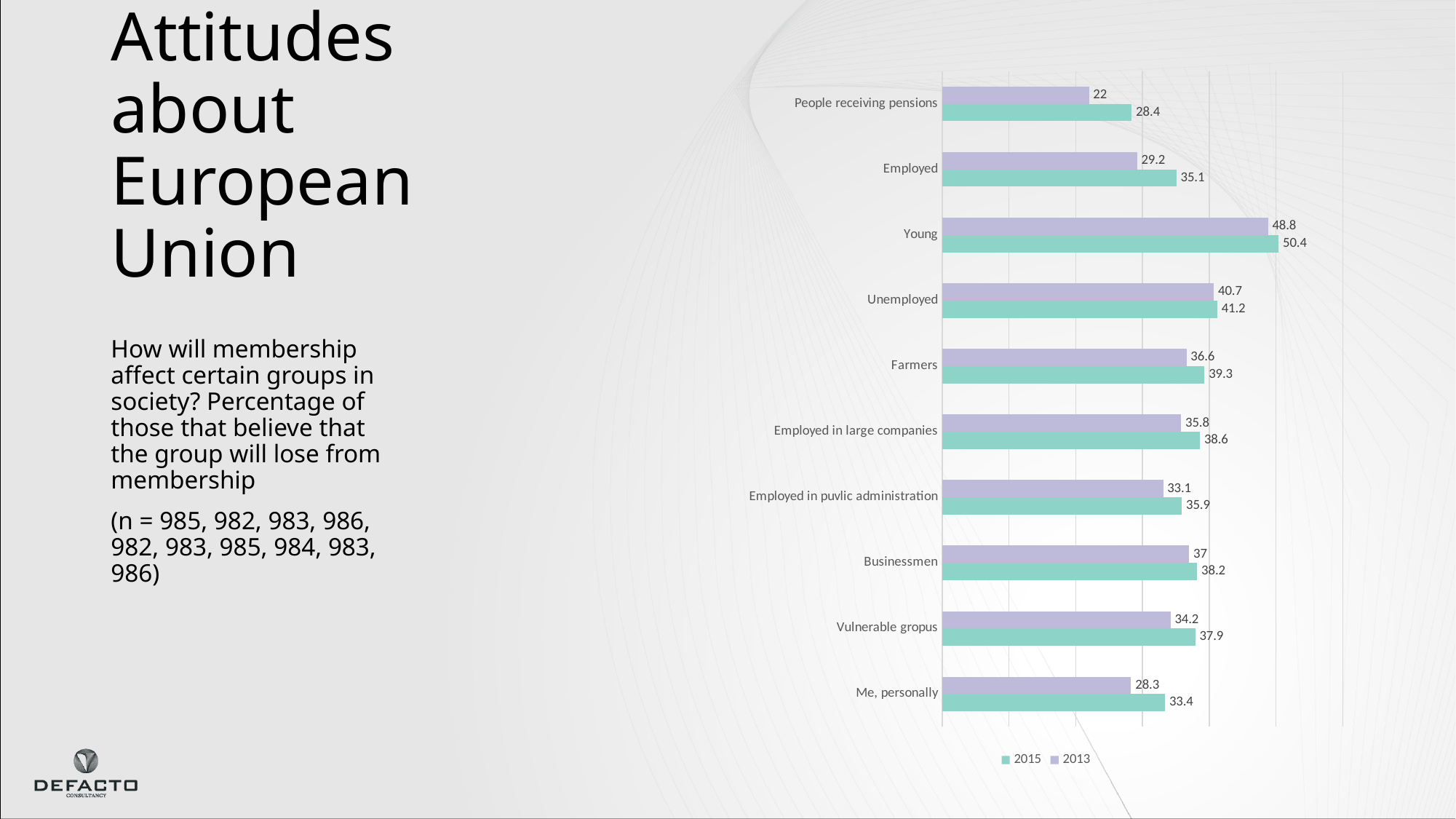
Which category has the highest 2015 value? Young What is the difference between the 2015 and 2013 values for Employed? 5.9 Which category has the lowest 2013 value? People receiving pensions What is the 2013 value for People receiving pensions? 22 What is the difference between the 2015 and 2013 values for People receiving pensions? 6.4 How many categories are shown on the chart? 10 What kind of chart is shown on the slide? Bar chart Which is larger, the 2015 value for Vulnerable gropus or the 2015 value for Me, personally? Vulnerable gropus How many series does the legend list? 2 What is the 2013 value for Businessmen? 37 What is the 2015 value for Young? 50.4 What is the 2015 value for Farmers? 39.3